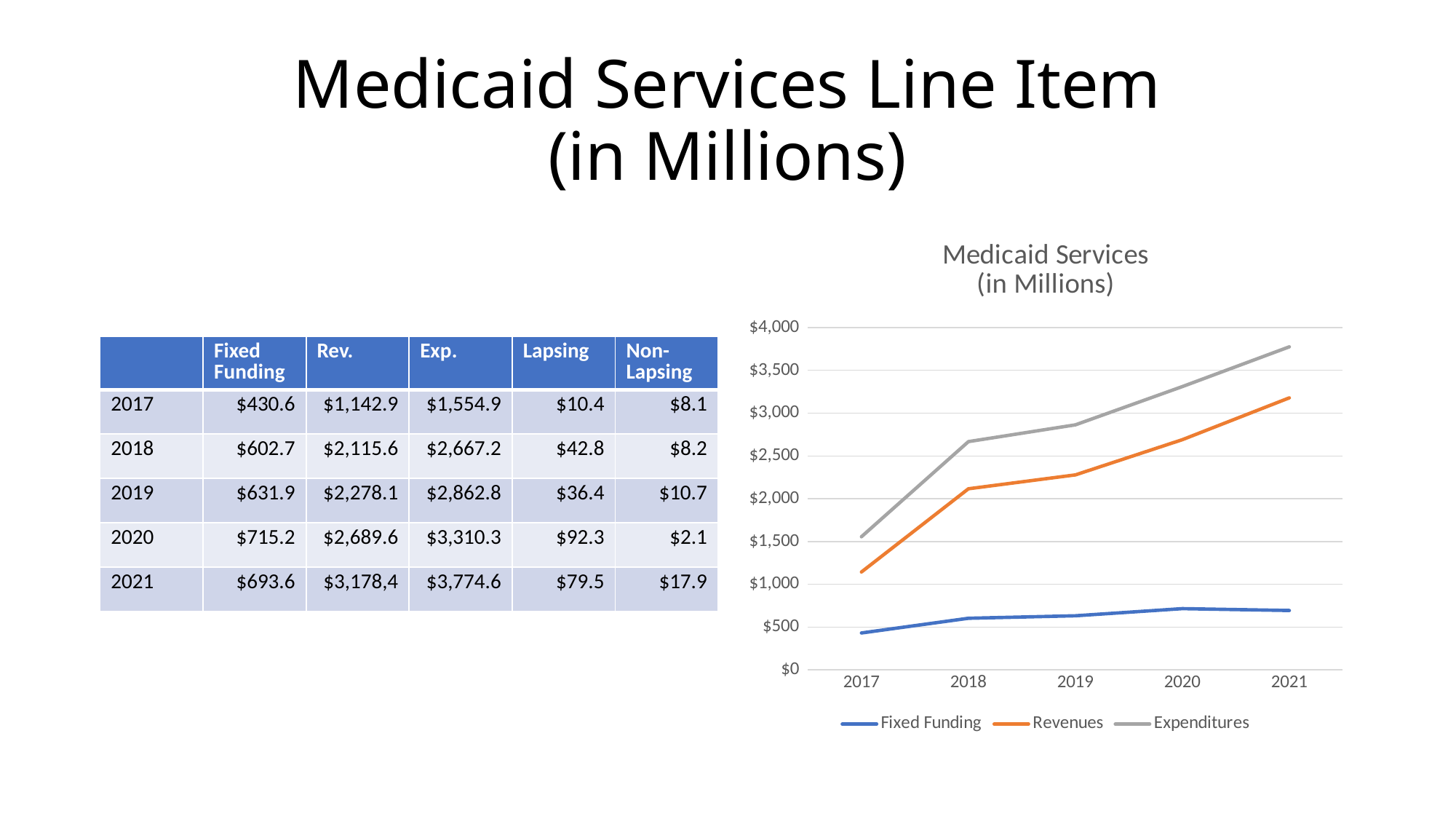
Which series has the lowest values across all years in the chart? Fixed Funding Is the Expenditures value for 2021 greater or less than $3,500? greater Which series is drawn in orange in the chart? Revenues How many series does the chart's legend list? 3 What is the title of the chart? Medicaid Services (in Millions) Is the Revenues value for 2017 greater or less than $1,500? less What kind of chart is shown on the slide? line chart Which series has the highest values across all years in the chart? Expenditures Is the Fixed Funding value for 2020 greater or less than $500? greater How many years are plotted along the x axis of the chart? 5 Do Expenditures rise or fall from 2017 to 2021 in the chart? rise In 2019, which is larger in the chart: Revenues or Expenditures? Expenditures